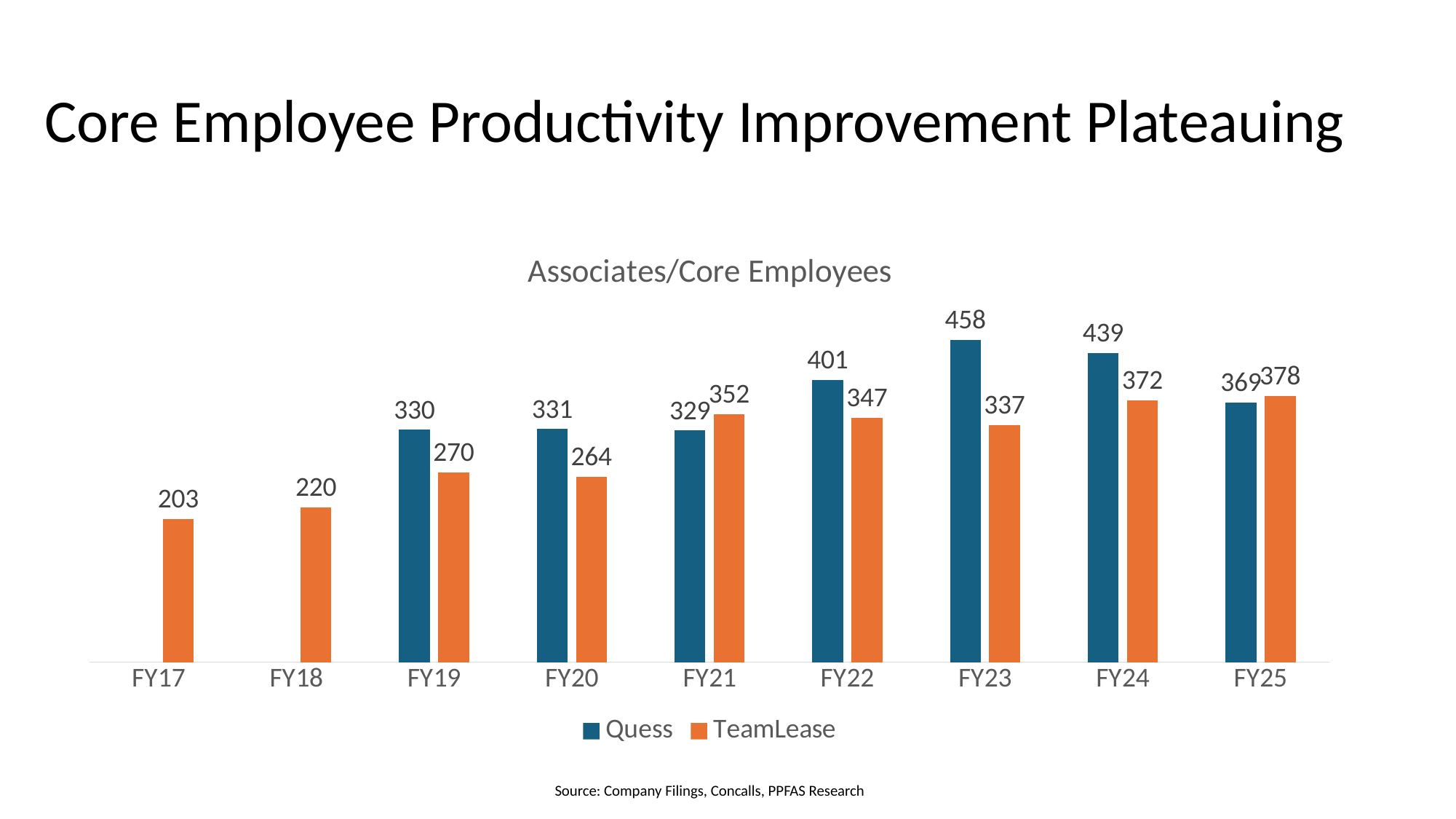
How many series does the legend list? 2 What kind of chart is shown on the slide? Bar chart What is the difference between the TeamLease values for FY24 and FY25? 6 What is the TeamLease value for FY25? 378 In which fiscal year is the Quess value highest? FY23 What is the difference between the Quess and TeamLease values in FY23? 121 In which fiscal year is the TeamLease value lowest? FY17 How many fiscal years are shown on the x axis? 9 What is the Quess value for FY23? 458 What is the title of the chart? Associates/Core Employees What is the TeamLease value for FY17? 203 In FY22, which series has the larger value, Quess or TeamLease? Quess